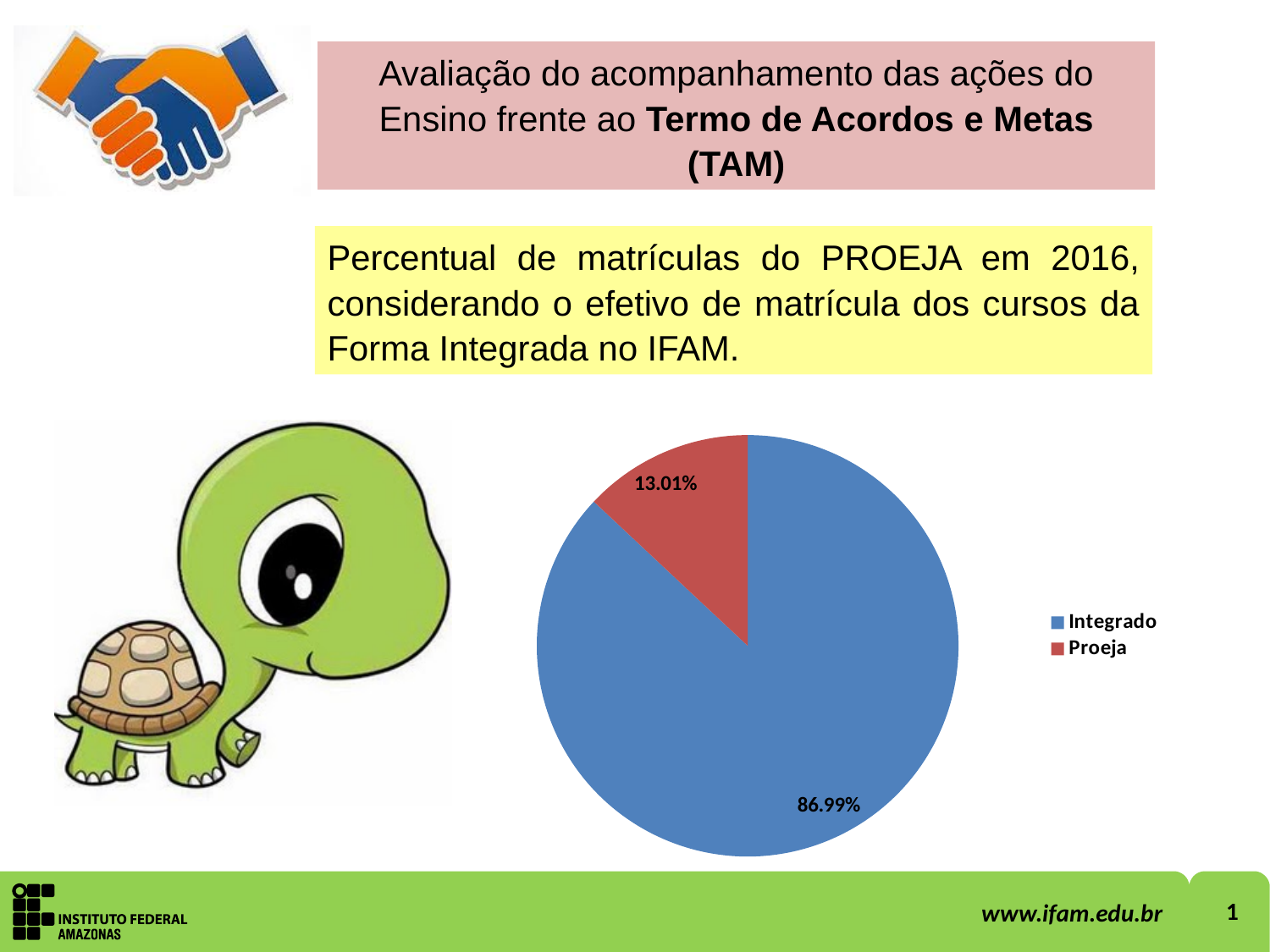
What share of the pie does Proeja represent? 13.01% Which category has the largest slice? Integrado What is the value for Proeja? 13.01% Which is larger, Integrado or Proeja? Integrado What is the value for Integrado? 86.99% How many slices does the pie chart have? 2 What is the difference between the Integrado and Proeja values? 73.98% What colour is the Proeja slice? red How many entries does the legend list? 2 What kind of chart is shown on the slide? pie chart Which category has the smallest slice? Proeja What colour is the Integrado slice? blue